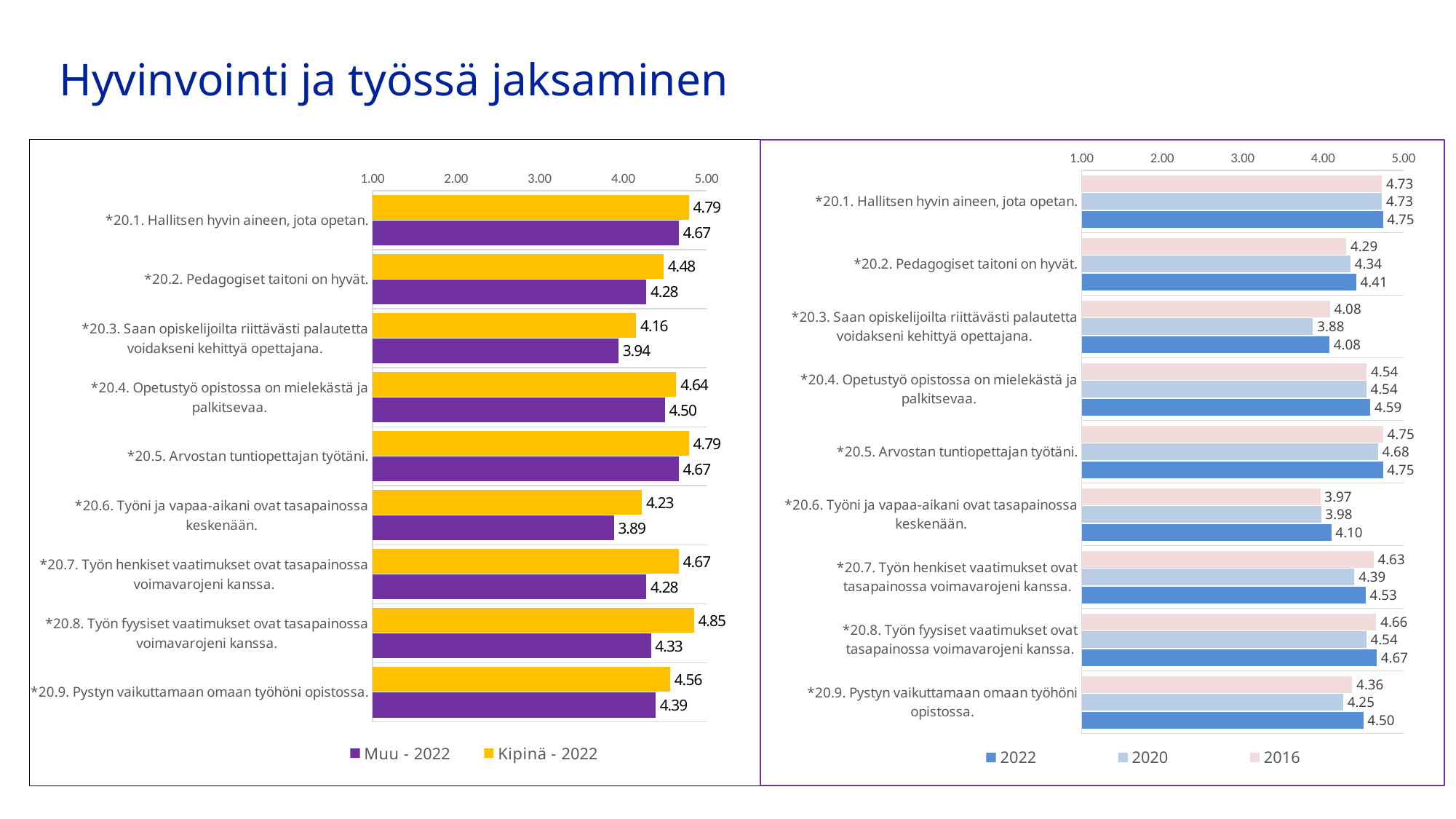
In the right chart, what is the 2016 value for *20.9. Pystyn vaikuttamaan omaan työhöni opistossa.? 4.36 In the left chart, which category has the highest Kipinä - 2022 value? *20.8. Työn fyysiset vaatimukset ovat tasapainossa voimavarojeni kanssa. In the left chart, what is the difference between the Kipinä - 2022 and Muu - 2022 values for *20.7. Työn henkiset vaatimukset ovat tasapainossa voimavarojeni kanssa.? 0.39 In the left chart, what is the Kipinä - 2022 value for *20.8. Työn fyysiset vaatimukset ovat tasapainossa voimavarojeni kanssa.? 4.85 In the left chart, how many series does the legend list? 2 What kind of chart is the left chart? Bar chart In the left chart, what is the Muu - 2022 value for *20.6. Työni ja vapaa-aikani ovat tasapainossa keskenään.? 3.89 In the left chart, which category has the lowest Muu - 2022 value? *20.6. Työni ja vapaa-aikani ovat tasapainossa keskenään. In the right chart, which is larger for *20.7. Työn henkiset vaatimukset ovat tasapainossa voimavarojeni kanssa.: the 2016 value or the 2022 value? 2016 In the right chart, what is the 2020 value for *20.3. Saan opiskelijoilta riittävästi palautetta voidakseni kehittyä opettajana.? 3.88 In the right chart, how many series does the legend list? 3 In the right chart, how many categories are shown? 9